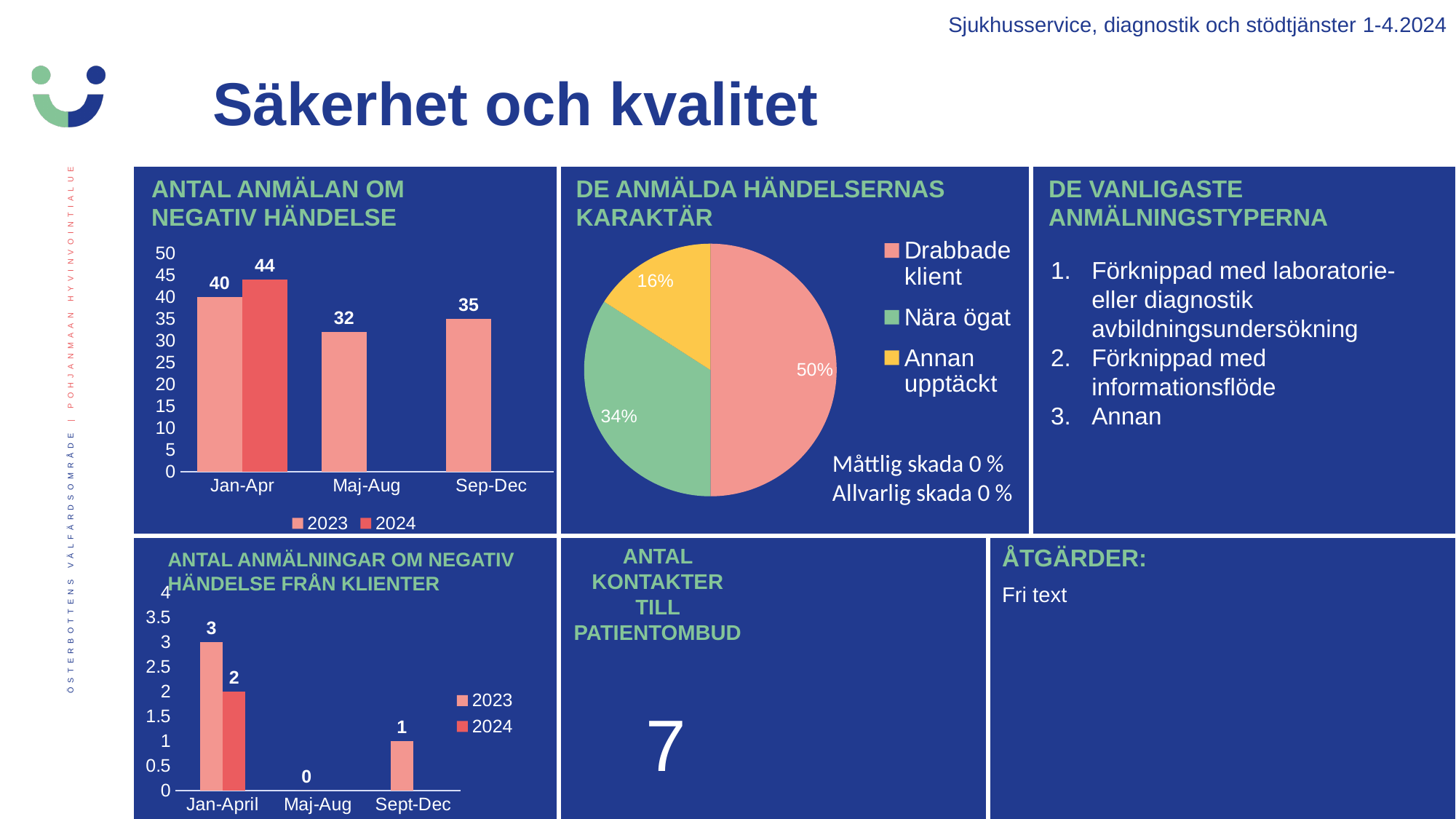
In the chart 'ANTAL ANMÄLAN OM NEGATIV HÄNDELSE', what is the difference between the 2024 and 2023 values for Jan-Apr? 4 In the chart 'ANTAL ANMÄLNINGAR OM NEGATIV HÄNDELSE FRÅN KLIENTER', what is the 2023 value for Jan-April? 3 In the chart 'ANTAL ANMÄLAN OM NEGATIV HÄNDELSE', what is the value for 2024 in Jan-Apr? 44 What kind of chart is 'DE ANMÄLDA HÄNDELSERNAS KARAKTÄR'? Pie chart In the chart 'ANTAL ANMÄLNINGAR OM NEGATIV HÄNDELSE FRÅN KLIENTER', which is larger for Jan-April: 2023 or 2024? 2023 In the chart 'ANTAL ANMÄLAN OM NEGATIV HÄNDELSE', how many series does the legend list? 2 In the chart 'ANTAL ANMÄLAN OM NEGATIV HÄNDELSE', which period has the lowest 2023 value? Maj-Aug In the pie chart 'DE ANMÄLDA HÄNDELSERNAS KARAKTÄR', what is the share for 'Nära ögat'? 34% In the pie chart 'DE ANMÄLDA HÄNDELSERNAS KARAKTÄR', which category has the smallest slice? Annan upptäckt In the pie chart 'DE ANMÄLDA HÄNDELSERNAS KARAKTÄR', what share does 'Drabbade klient' have? 50% In the chart 'ANTAL ANMÄLNINGAR OM NEGATIV HÄNDELSE FRÅN KLIENTER', how many periods are shown on the x axis? 3 In the chart 'ANTAL ANMÄLAN OM NEGATIV HÄNDELSE', what is the value for 2023 in Jan-Apr? 40